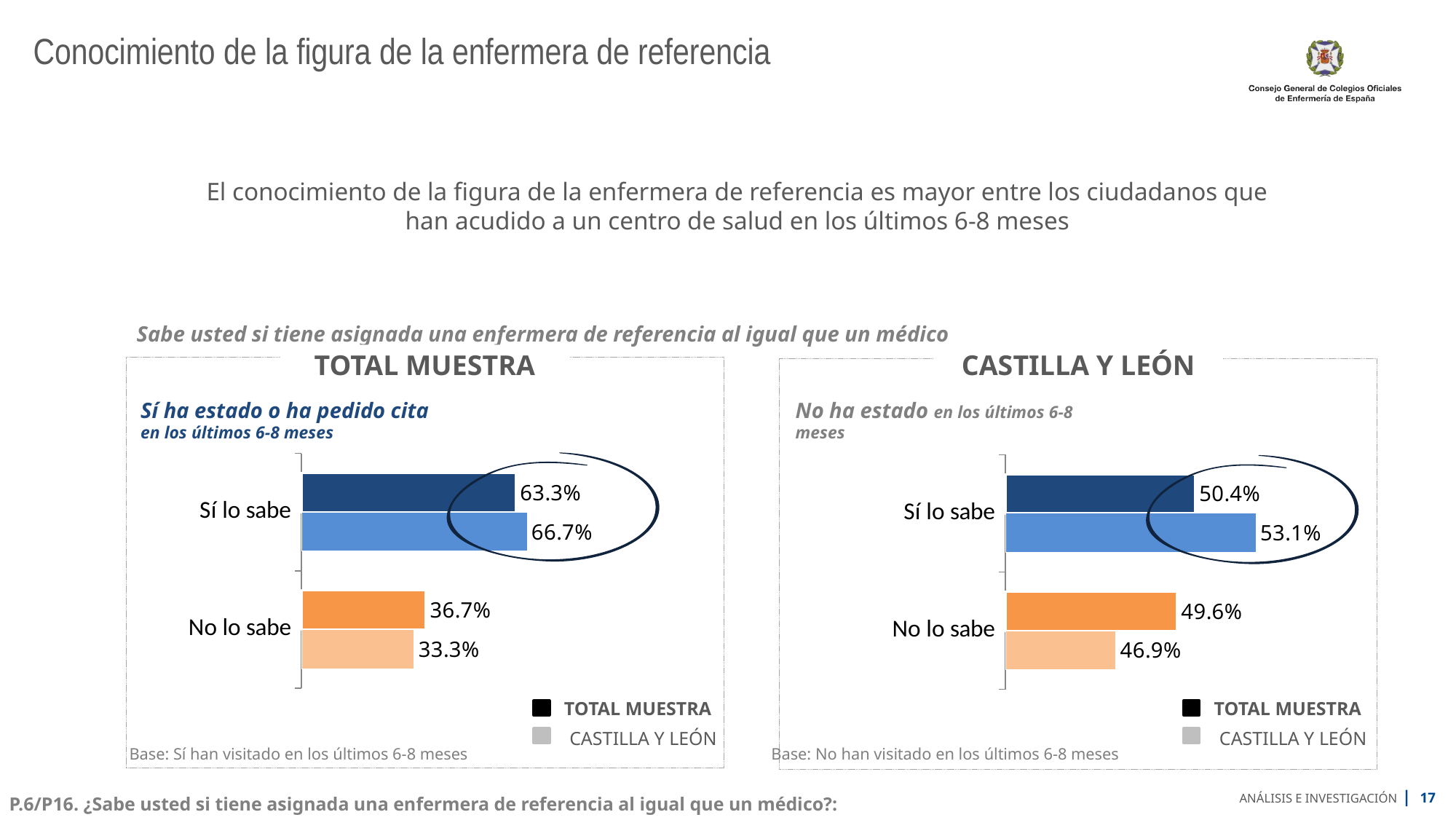
In the left chart (Sí ha estado o ha pedido cita en los últimos 6-8 meses), what is the TOTAL MUESTRA value for 'Sí lo sabe'? 63.3% How many series does the legend of the right chart (No ha estado en los últimos 6-8 meses) list? 2 In the right chart (No ha estado en los últimos 6-8 meses), which series has the higher value for 'No lo sabe'? TOTAL MUESTRA What type of chart is used in the right chart (No ha estado en los últimos 6-8 meses)? Bar chart In the left chart (Sí ha estado o ha pedido cita en los últimos 6-8 meses), which bar has the highest value? CASTILLA Y LEÓN, Sí lo sabe (66.7%) In the left chart (Sí ha estado o ha pedido cita en los últimos 6-8 meses), what is the CASTILLA Y LEÓN value for 'No lo sabe'? 33.3% In the right chart (No ha estado en los últimos 6-8 meses), what is the CASTILLA Y LEÓN value for 'Sí lo sabe'? 53.1% How many categories are shown in the left chart (Sí ha estado o ha pedido cita en los últimos 6-8 meses)? 2 In the right chart (No ha estado en los últimos 6-8 meses), what is the TOTAL MUESTRA value for 'No lo sabe'? 49.6% In the left chart (Sí ha estado o ha pedido cita en los últimos 6-8 meses), which is larger for 'Sí lo sabe': TOTAL MUESTRA or CASTILLA Y LEÓN? CASTILLA Y LEÓN In the right chart (No ha estado en los últimos 6-8 meses), what is the difference between the TOTAL MUESTRA values for 'Sí lo sabe' and 'No lo sabe'? 0.8% In the left chart (Sí ha estado o ha pedido cita en los últimos 6-8 meses), what is the difference between the CASTILLA Y LEÓN and TOTAL MUESTRA values for 'Sí lo sabe'? 3.4%